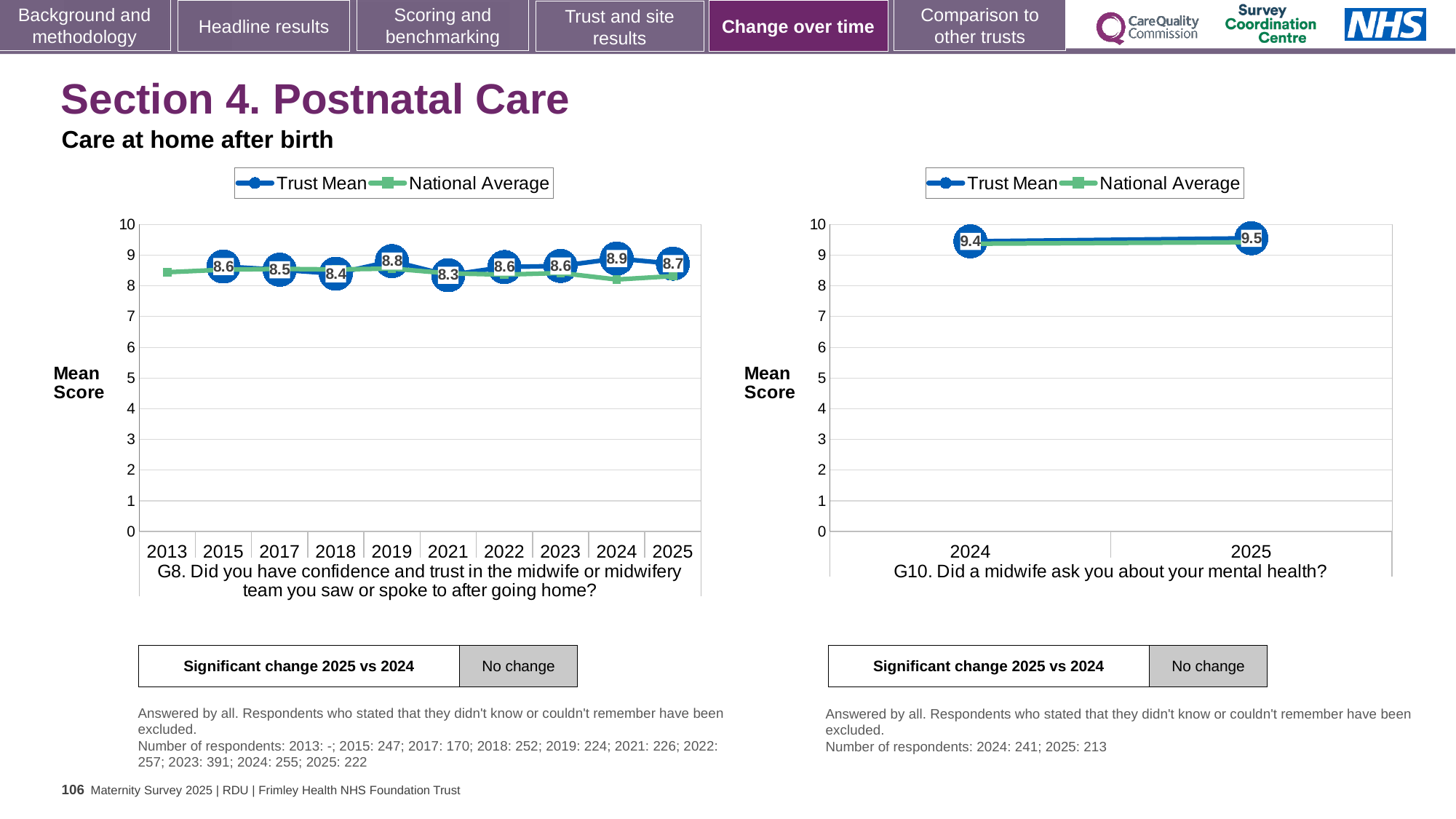
How many series does the legend of the G10 chart on the right list? 2 What kind of chart is the G10 chart on the right? Line chart In the G8 chart on the left, which year has the highest Trust Mean? 2024 In the G8 chart on the left, what is the Trust Mean for 2024? 8.9 In the G10 chart on the right, what is the Trust Mean for 2025? 9.5 In the G8 chart on the left, is the Trust Mean higher in 2019 or in 2018? 2019 In the G8 chart on the left, what is the difference between the Trust Mean for 2024 and the Trust Mean for 2025? 0.2 In the G10 chart on the right, what is the difference between the Trust Mean for 2025 and the Trust Mean for 2024? 0.1 In the G8 chart on the left, is the National Average for 2013 greater or less than 9? less In the G8 chart on the left, which year has the lowest Trust Mean? 2021 In the G8 chart on the left, what is the Trust Mean for 2021? 8.3 How many years are shown on the x axis of the G8 chart on the left? 10